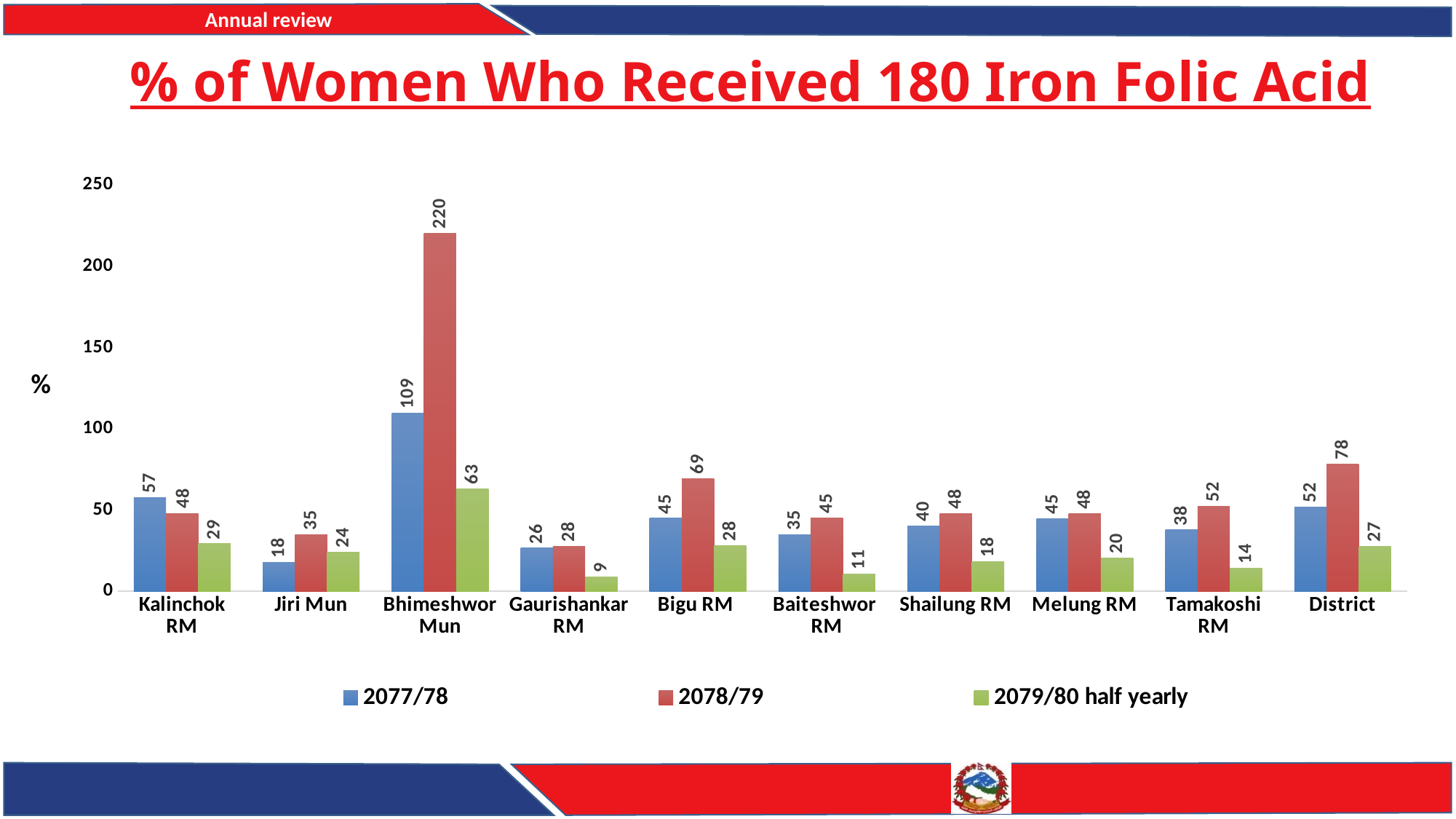
Which is larger for Bigu RM: the 2077/78 value or the 2078/79 value? 2078/79 What is the difference between the 2078/79 and 2077/78 values for Bhimeshwor Mun? 111 What is the value for Bhimeshwor Mun in the 2078/79 series? 220 What is the title of the chart? % of Women Who Received 180 Iron Folic Acid How many categories are shown on the x axis? 10 Which category has the lowest value in the 2079/80 half yearly series? Gaurishankar RM How many series does the legend list? 3 What is the value for Tamakoshi RM in the 2077/78 series? 38 Is the 2078/79 value for Bhimeshwor Mun greater or less than 200? greater What kind of chart is shown on the slide? bar chart Which category has the highest value in the 2078/79 series? Bhimeshwor Mun What is the value for District in the 2079/80 half yearly series? 27